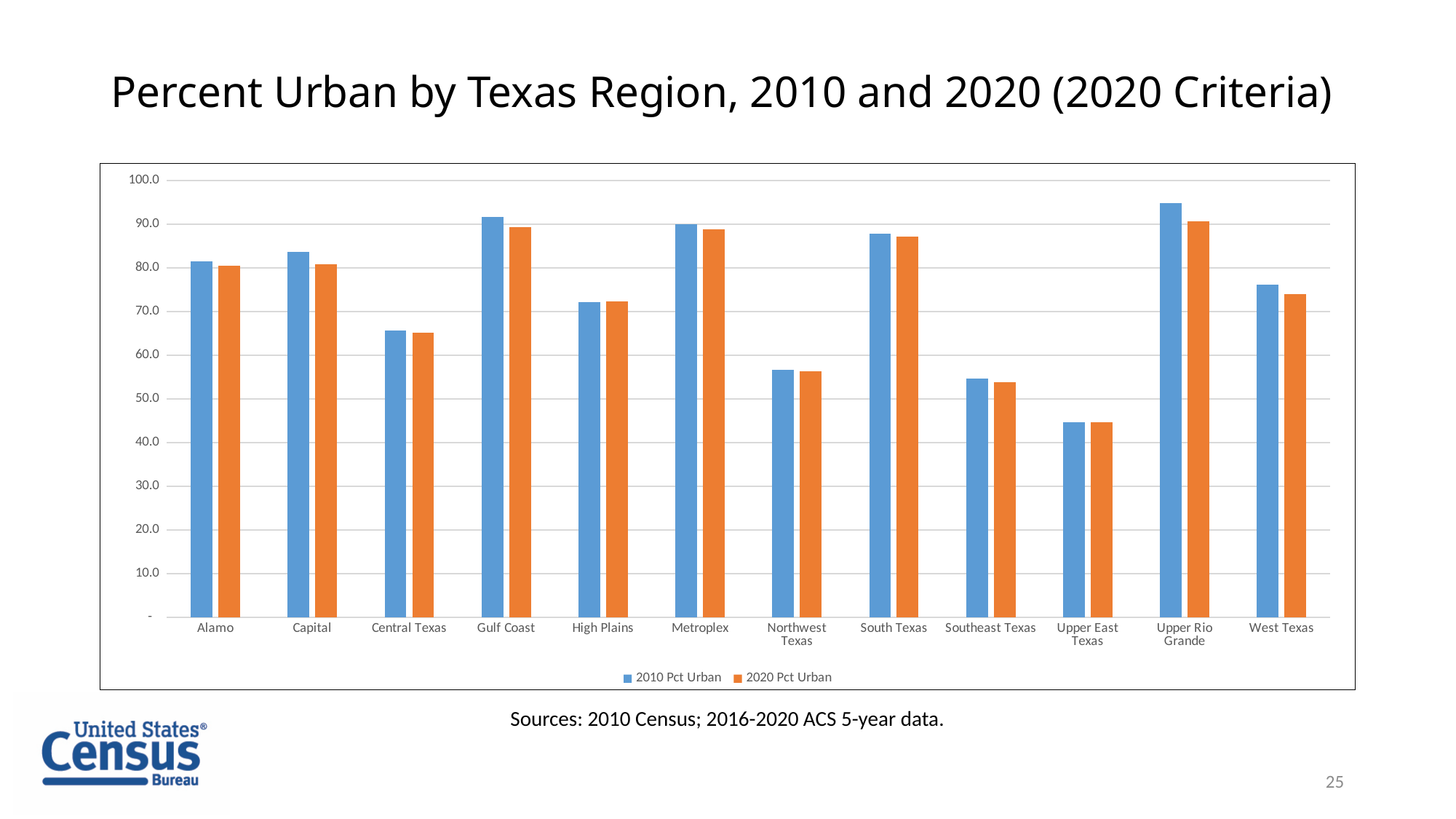
Which region has the lowest 2020 Pct Urban value? Upper East Texas Is the 2010 Pct Urban value for Upper Rio Grande greater or less than 90.0? greater How many series does the chart's legend list? 2 Which region has the highest 2010 Pct Urban value? Upper Rio Grande Is the 2020 Pct Urban value for Northwest Texas greater or less than 50.0? greater What kind of chart is shown on the slide? Bar chart Is the 2010 Pct Urban value for Upper East Texas greater or less than 50.0? less How many Texas regions are shown on the x axis of the chart? 12 What are the two series named in the chart's legend? 2010 Pct Urban and 2020 Pct Urban Which region has the lowest 2010 Pct Urban value? Upper East Texas Which has the larger 2010 Pct Urban value, Gulf Coast or Central Texas? Gulf Coast